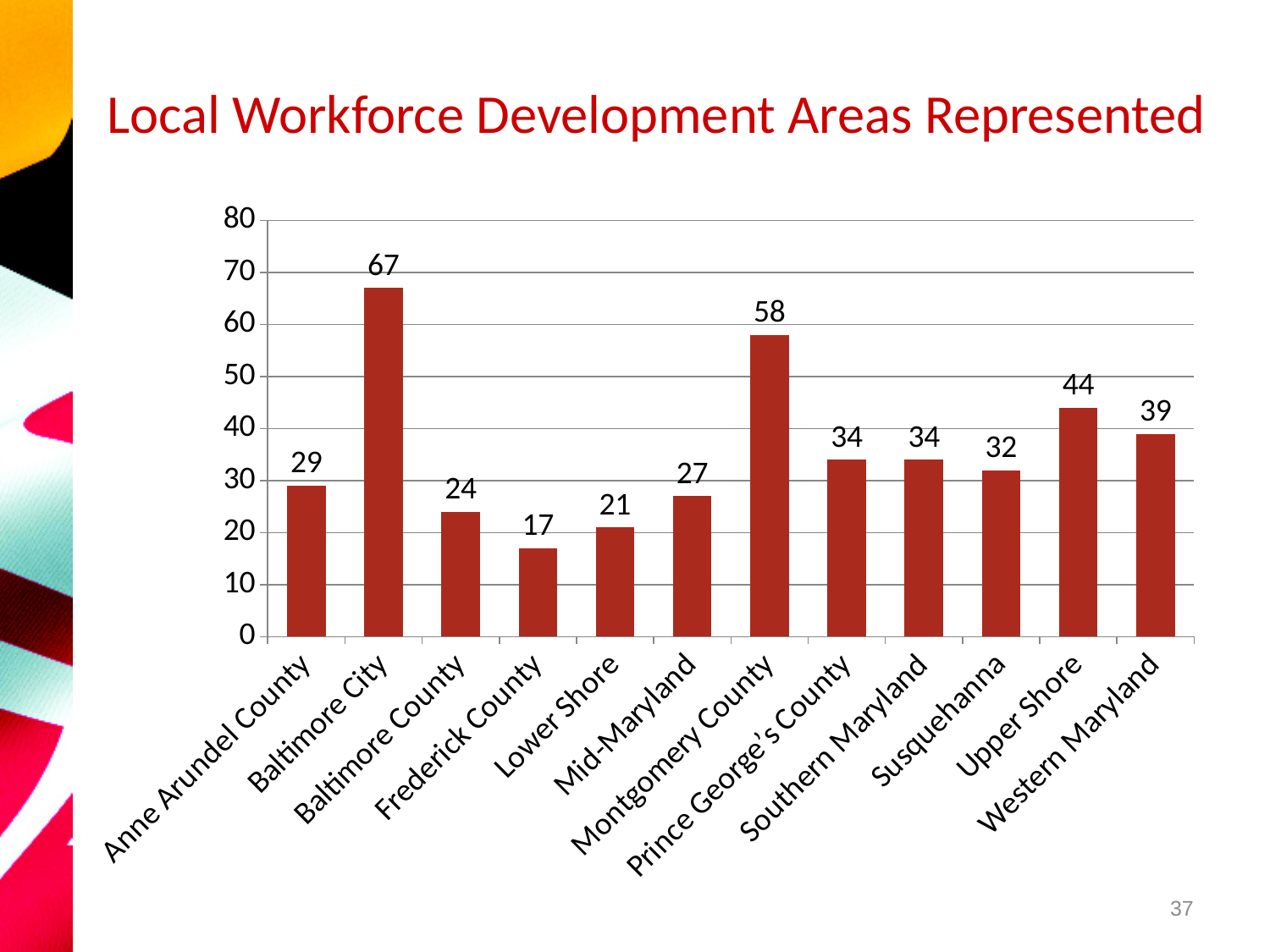
Which is larger, the value for Western Maryland or the value for Susquehanna? Western Maryland How many local workforce development areas are shown on the chart? 12 Is the value for Lower Shore greater or less than 30? less What is the title of the slide? Local Workforce Development Areas Represented What is the value for Frederick County? 17 What is the difference between the values for Baltimore City and Montgomery County? 9 Which local workforce development area has the highest value? Baltimore City What is the value for Montgomery County? 58 What is the value for Baltimore City? 67 What kind of chart is shown on the slide? Bar chart Which local workforce development area has the lowest value? Frederick County What is the value for Upper Shore? 44